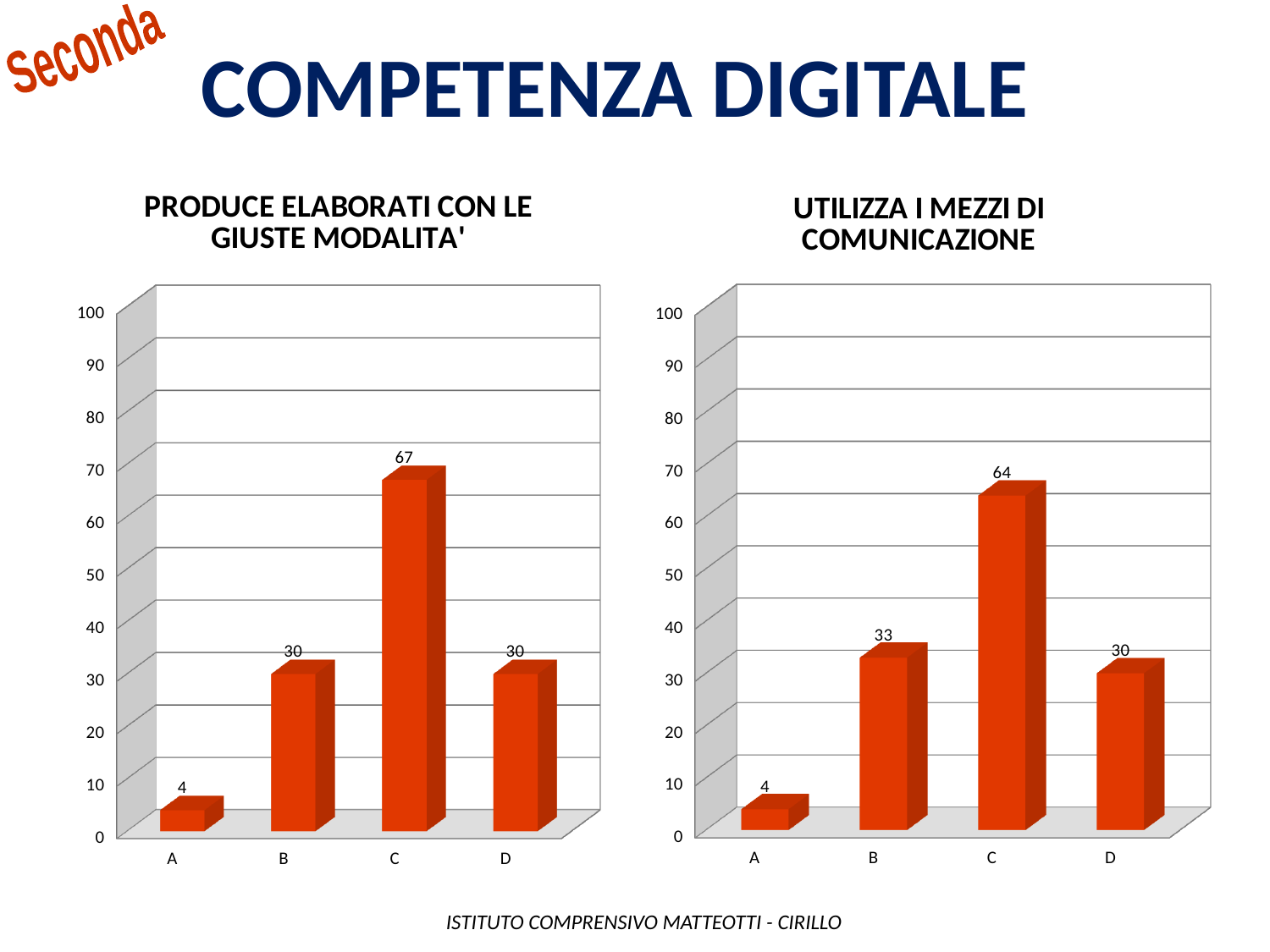
In the chart titled 'UTILIZZA I MEZZI DI COMUNICAZIONE', what is the value for category A? 4 What is the title of the chart on the right side of the slide? UTILIZZA I MEZZI DI COMUNICAZIONE What kind of chart is the chart titled 'PRODUCE ELABORATI CON LE GIUSTE MODALITA''? Bar chart In the chart titled 'UTILIZZA I MEZZI DI COMUNICAZIONE', what is the value for category B? 33 In the chart titled 'PRODUCE ELABORATI CON LE GIUSTE MODALITA'', is the value for C greater or less than 60? greater In the chart titled 'UTILIZZA I MEZZI DI COMUNICAZIONE', which is larger, the value for B or the value for D? B In the chart titled 'PRODUCE ELABORATI CON LE GIUSTE MODALITA'', what is the value for category C? 67 In the chart titled 'UTILIZZA I MEZZI DI COMUNICAZIONE', what is the difference between the values for C and D? 34 In the chart titled 'PRODUCE ELABORATI CON LE GIUSTE MODALITA'', what is the difference between the values for C and B? 37 In the chart titled 'PRODUCE ELABORATI CON LE GIUSTE MODALITA'', which category has the lowest value? A In the chart titled 'UTILIZZA I MEZZI DI COMUNICAZIONE', which category has the highest value? C How many categories are shown in the chart titled 'UTILIZZA I MEZZI DI COMUNICAZIONE'? 4